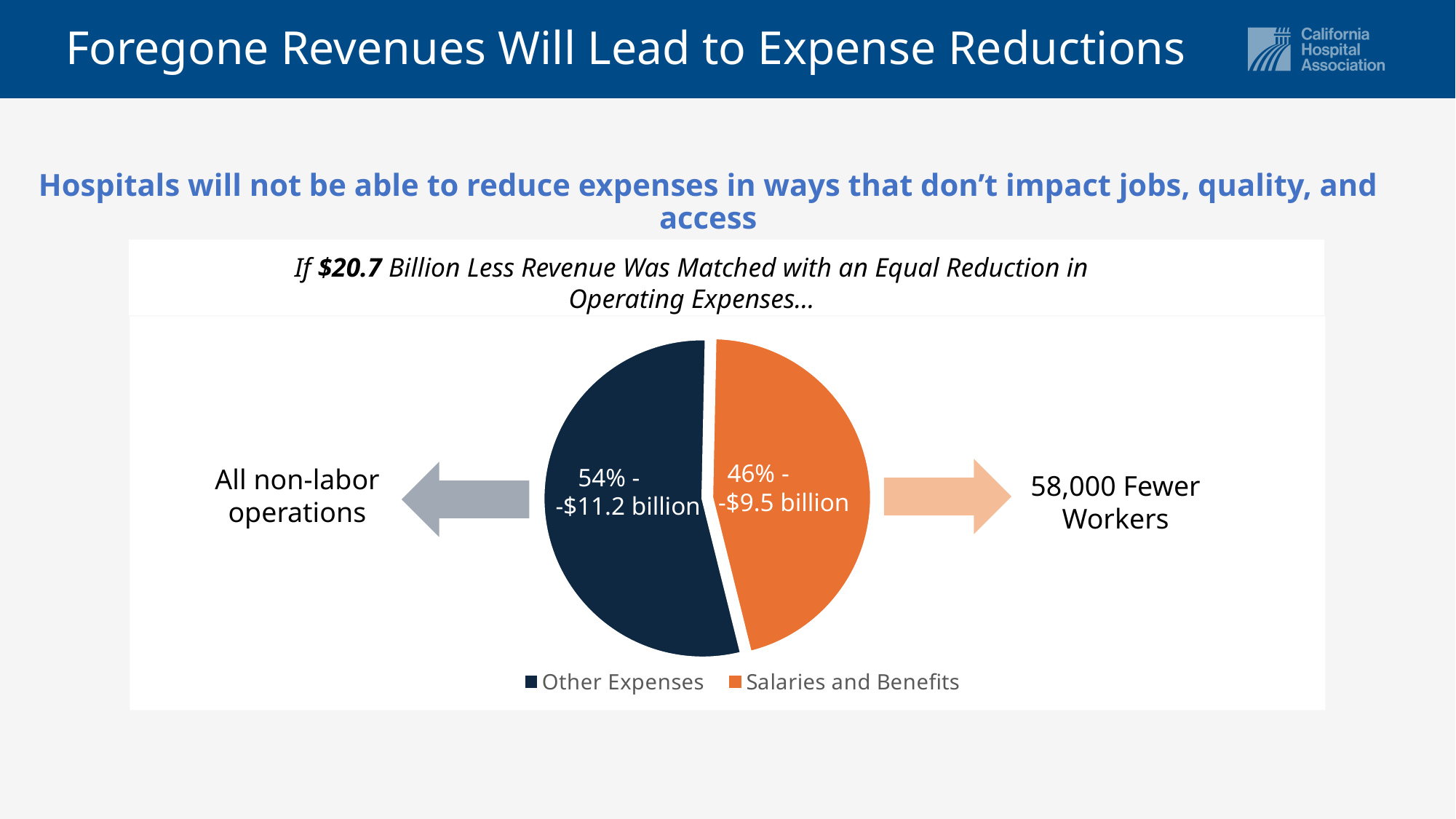
Which slice of the pie is the largest? Other Expenses What dollar value is labeled on the Other Expenses slice? -$11.2 billion How many entries does the legend list? 2 What share of the pie is Other Expenses? 54% What share of the pie is Salaries and Benefits? 46% Which is larger, the Other Expenses share or the Salaries and Benefits share? Other Expenses Which slice of the pie is the smallest? Salaries and Benefits What is the title of the chart? If $20.7 Billion Less Revenue Was Matched with an Equal Reduction in Operating Expenses... What kind of chart is shown on the slide? Pie chart How many slices does the pie chart have? 2 What is the difference in percentage points between the Other Expenses share and the Salaries and Benefits share? 8 percentage points What dollar value is labeled on the Salaries and Benefits slice? -$9.5 billion